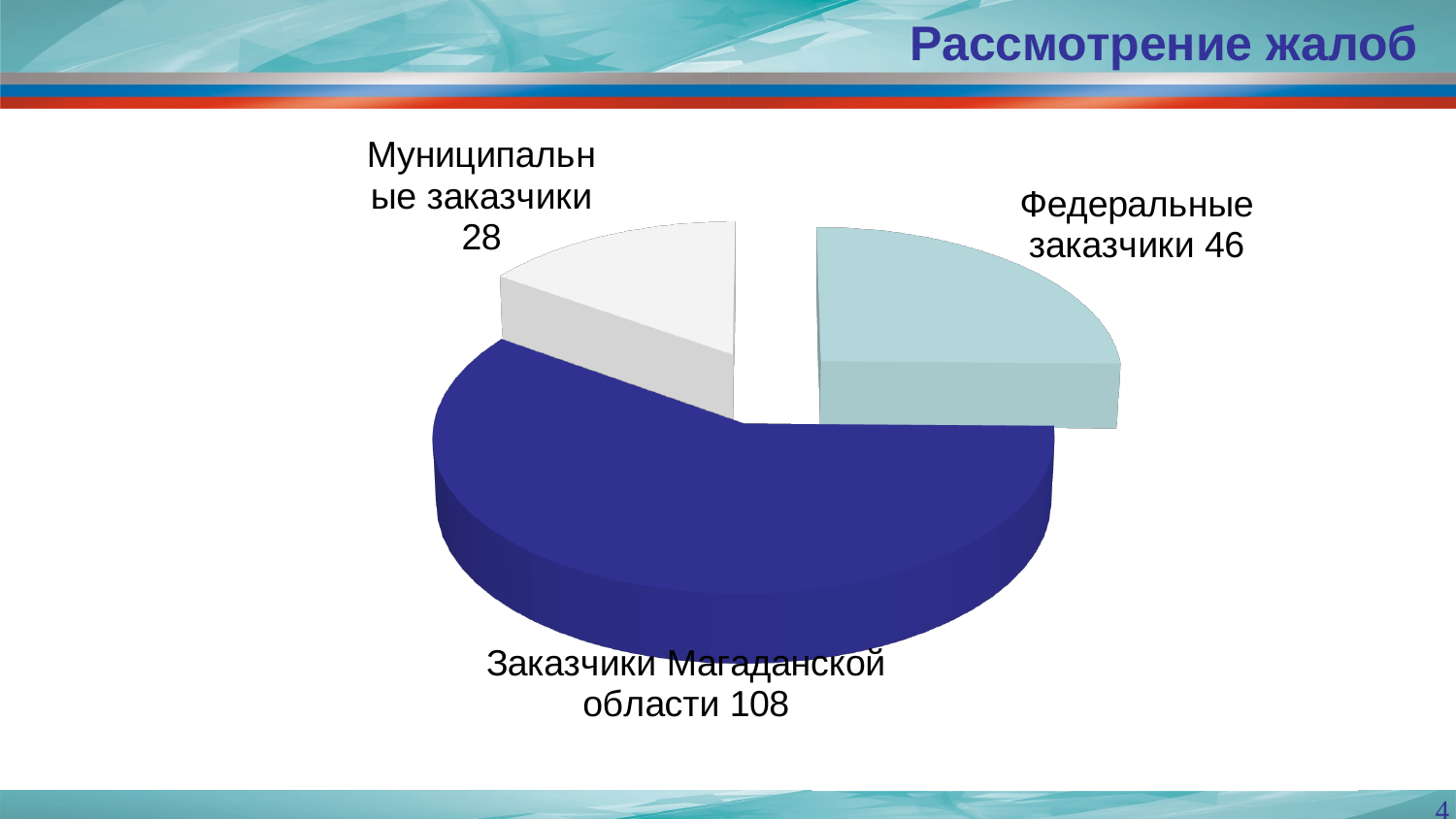
What is the value for Муниципальные заказчики? 28 Which category has the smallest slice of the pie? Муниципальные заказчики Which category has the largest slice of the pie? Заказчики Магаданской области What is the difference between the values for Заказчики Магаданской области and Федеральные заказчики? 62 What is the difference between the values for Федеральные заказчики and Муниципальные заказчики? 18 How many categories does the pie chart have? 3 What kind of chart is shown on the slide? pie chart What is the total of all slices in the pie chart? 182 What is the value for Заказчики Магаданской области? 108 What is the value for Федеральные заказчики? 46 What is the title of the slide containing the chart? Рассмотрение жалоб Which is larger, the value for Федеральные заказчики or the value for Муниципальные заказчики? Федеральные заказчики